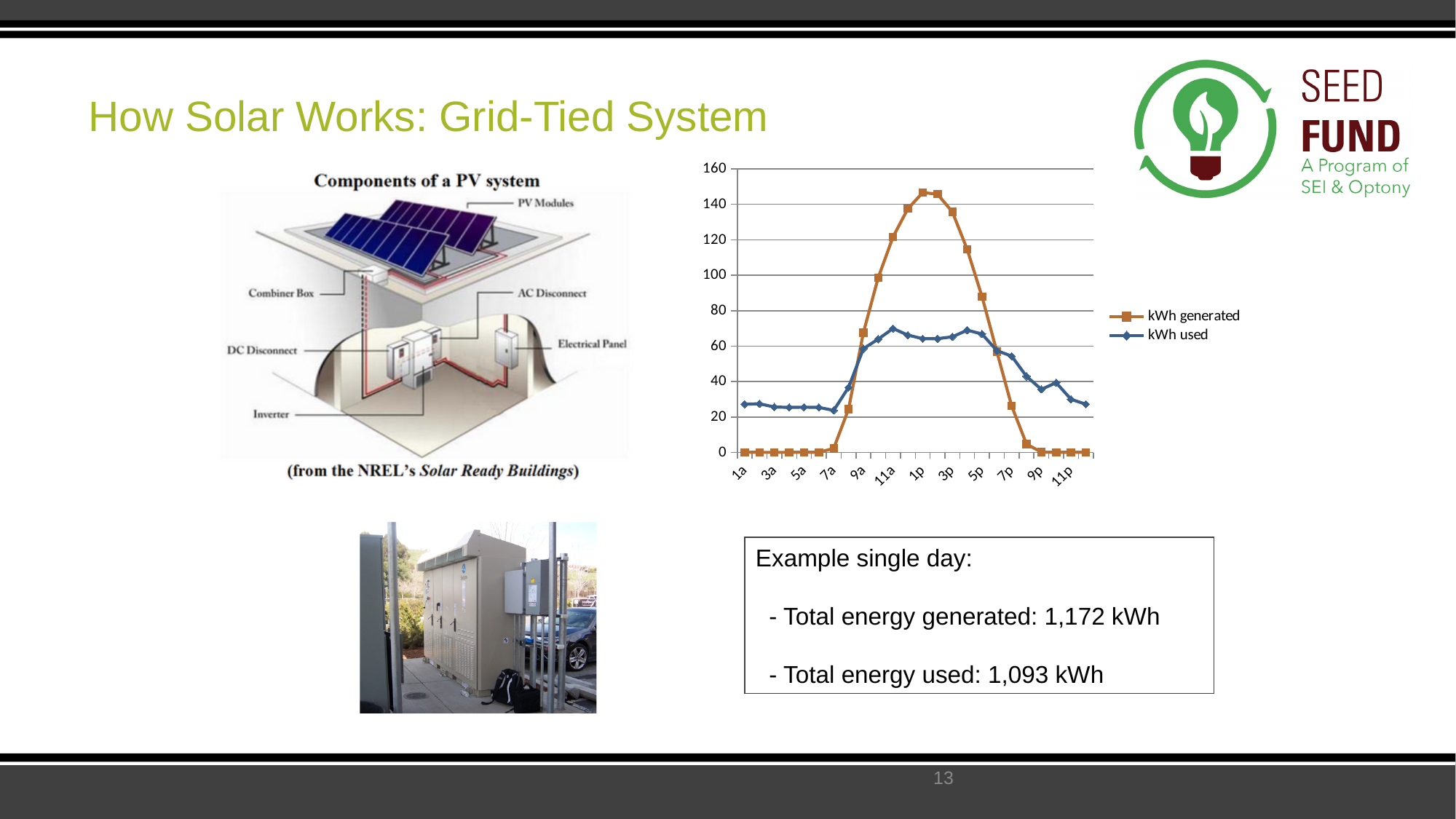
At 1p, which series has the larger value, kWh generated or kWh used? kWh generated Is the value for kWh used at 11a greater or less than 40? greater How many series does the chart's legend list? 2 Which series in the chart is drawn in orange with square markers? kWh generated Is the value for kWh generated at 3a greater or less than 20? less What are the two series named in the chart's legend? kWh generated and kWh used Is the value for kWh generated at 1p greater or less than 140? greater Does the kWh generated series rise or fall between 7a and 1p? rise How many time labels are shown along the chart's x axis? 12 At 9p, which series has the larger value, kWh generated or kWh used? kWh used What kind of chart is shown on the slide? Line chart